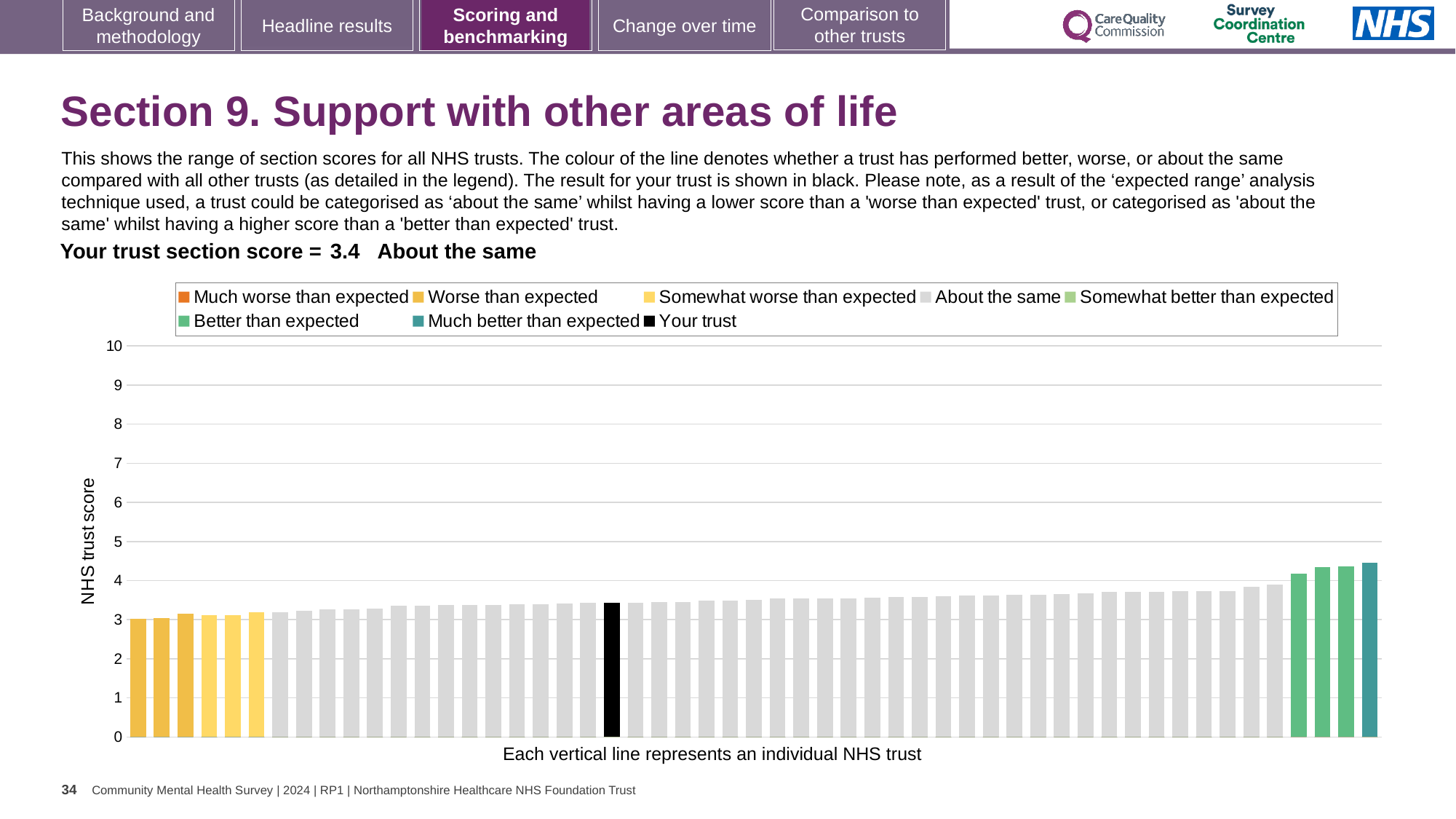
Which category does your trust fall into according to the slide? About the same Is the value of the black 'Your trust' bar greater or less than 4? less Is the value of the tallest bar in the chart greater or less than 5? less Is the value of the tallest bar in the chart greater or less than 4? greater What is the label on the vertical axis of the chart? NHS trust score How many bars are coloured as 'Better than expected' (green) in the chart? 3 How many entries does the chart legend list? 8 What kind of chart is shown on the slide? bar chart Which legend category does the tallest bar in the chart belong to? Much better than expected What is the section score for your trust shown on the slide? 3.4 How many bars are coloured as 'Worse than expected' (yellow) in the chart? 3 Which legend category does the shortest bar in the chart belong to? Worse than expected